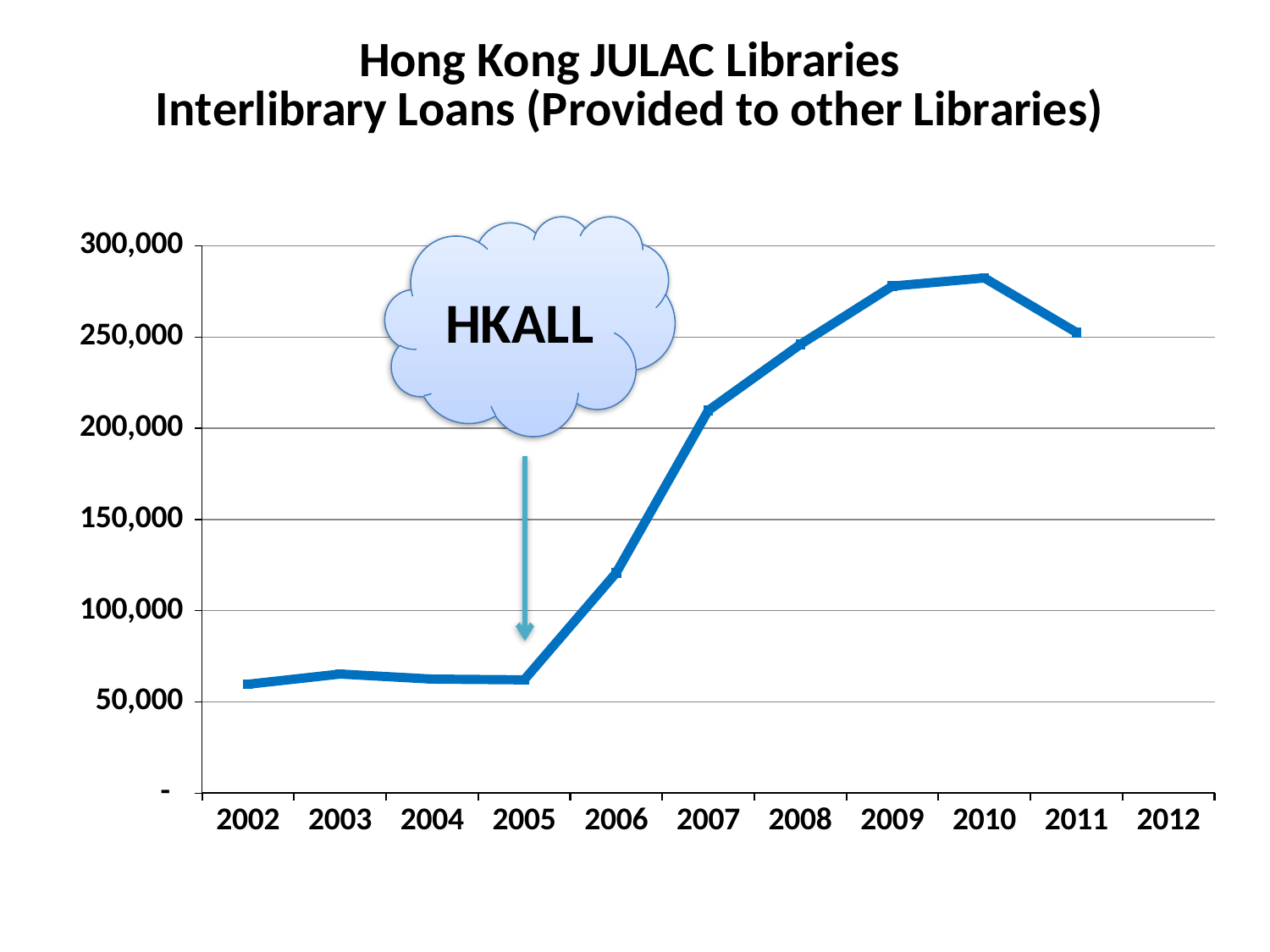
Is the value for 2005 greater or less than 100,000? less Is the value for 2007 greater or less than 200,000? greater How many years are labelled on the x axis? 11 What kind of chart is shown on the slide? line chart Do the values rise or fall from 2005 to 2010? rise Which year has the larger value, 2010 or 2011? 2010 Is the value for 2009 greater or less than 250,000? greater What is the title of the chart? Hong Kong JULAC Libraries Interlibrary Loans (Provided to other Libraries) Which year has the larger value, 2006 or 2007? 2007 Which year has the highest number of interlibrary loans? 2010 What label is shown in the cloud callout pointing to 2005? HKALL